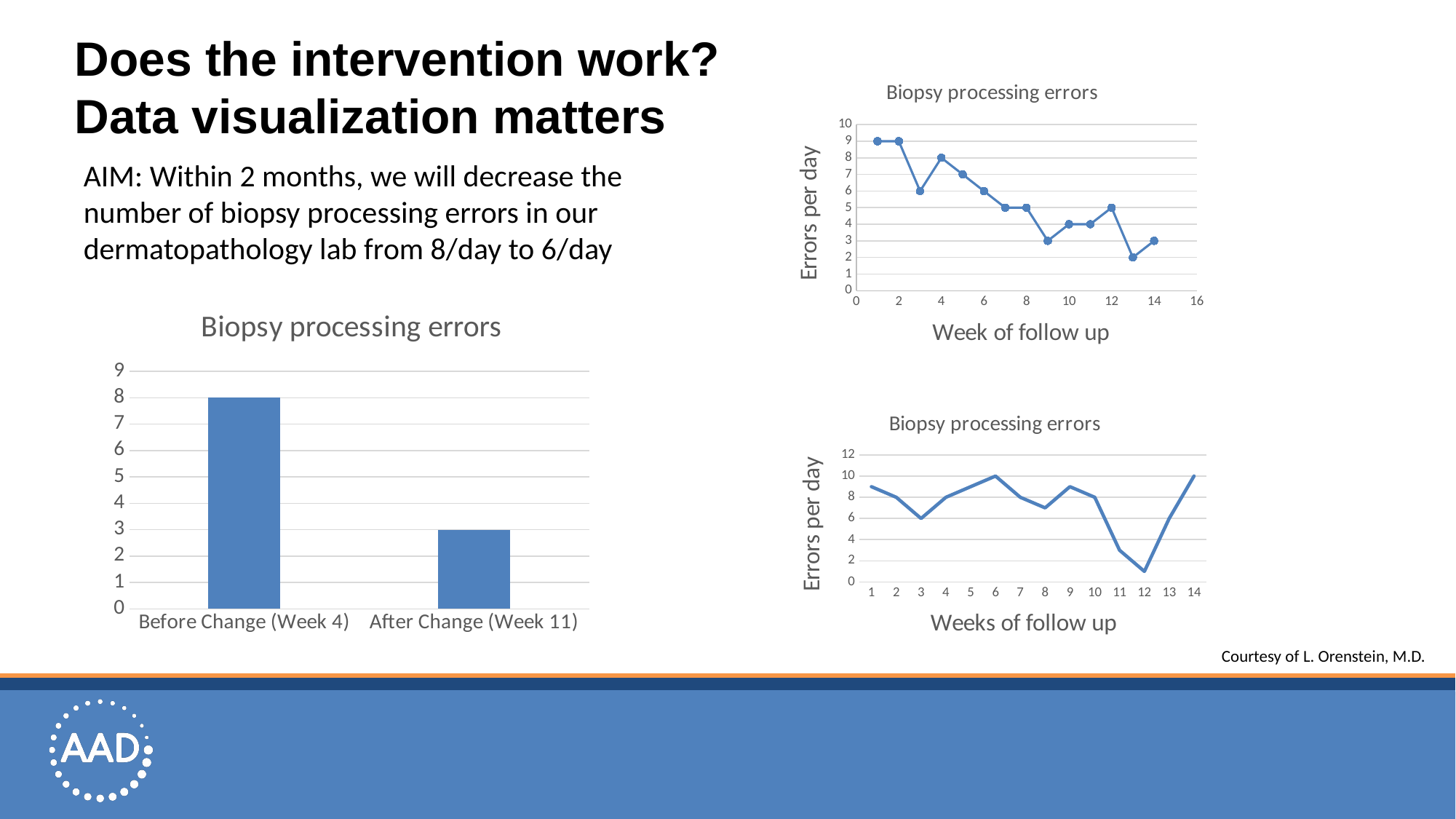
What kind of chart is the chart at the bottom left of the slide? bar chart On the bar chart at the bottom left, what is the value for Before Change (Week 4)? 8 What is the x-axis label of the line chart at the top right? Week of follow up On the line chart at the bottom right, is the value at week 12 greater or less than 2? less On the bar chart at the bottom left, what is the value for After Change (Week 11)? 3 On the line chart at the top right, what is the errors per day value at week 13? 2 On the bar chart at the bottom left, what is the difference between the Before Change (Week 4) and After Change (Week 11) values? 5 On the line chart at the bottom right, which is larger, the value at week 6 or the value at week 11? week 6 How many categories does the bar chart at the bottom left show? 2 On the line chart at the top right, which week has the lowest errors per day? 13 On the line chart at the top right, do errors per day generally rise or fall across the weeks of follow up? fall On the line chart at the top right, what is the errors per day value at week 4? 8